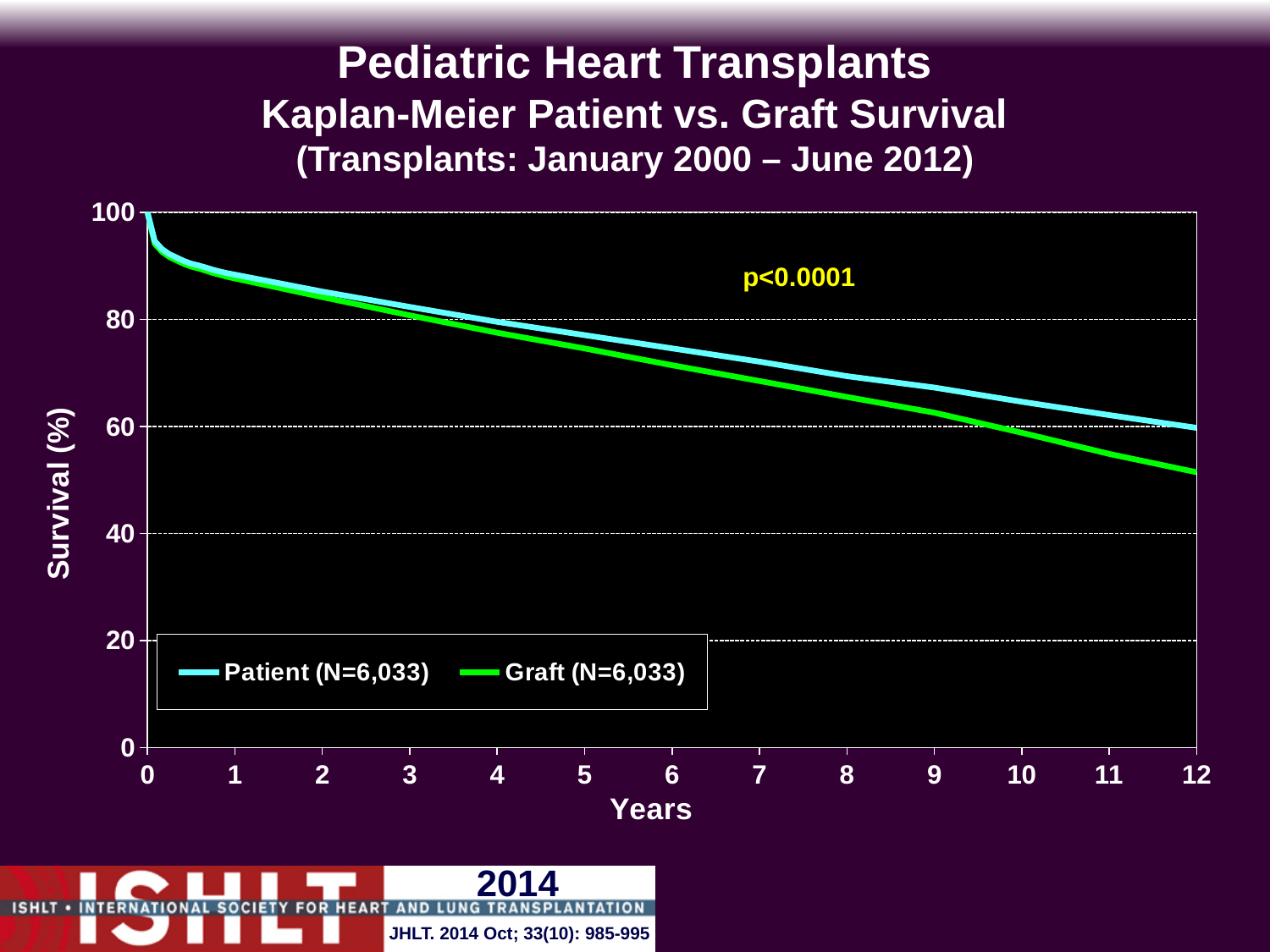
Is the Graft survival at 6 years greater or less than 80? less Do the survival curves rise or fall as the years increase? fall Is the Patient survival at 2 years greater or less than 80? greater Which series has the higher survival at 12 years, Patient or Graft? Patient Is the Graft survival at 12 years greater or less than 60? less How many series does the legend list? 2 Which series is drawn in green? Graft (N=6,033) What kind of chart is shown on the slide? line chart What p-value is printed on the chart? p<0.0001